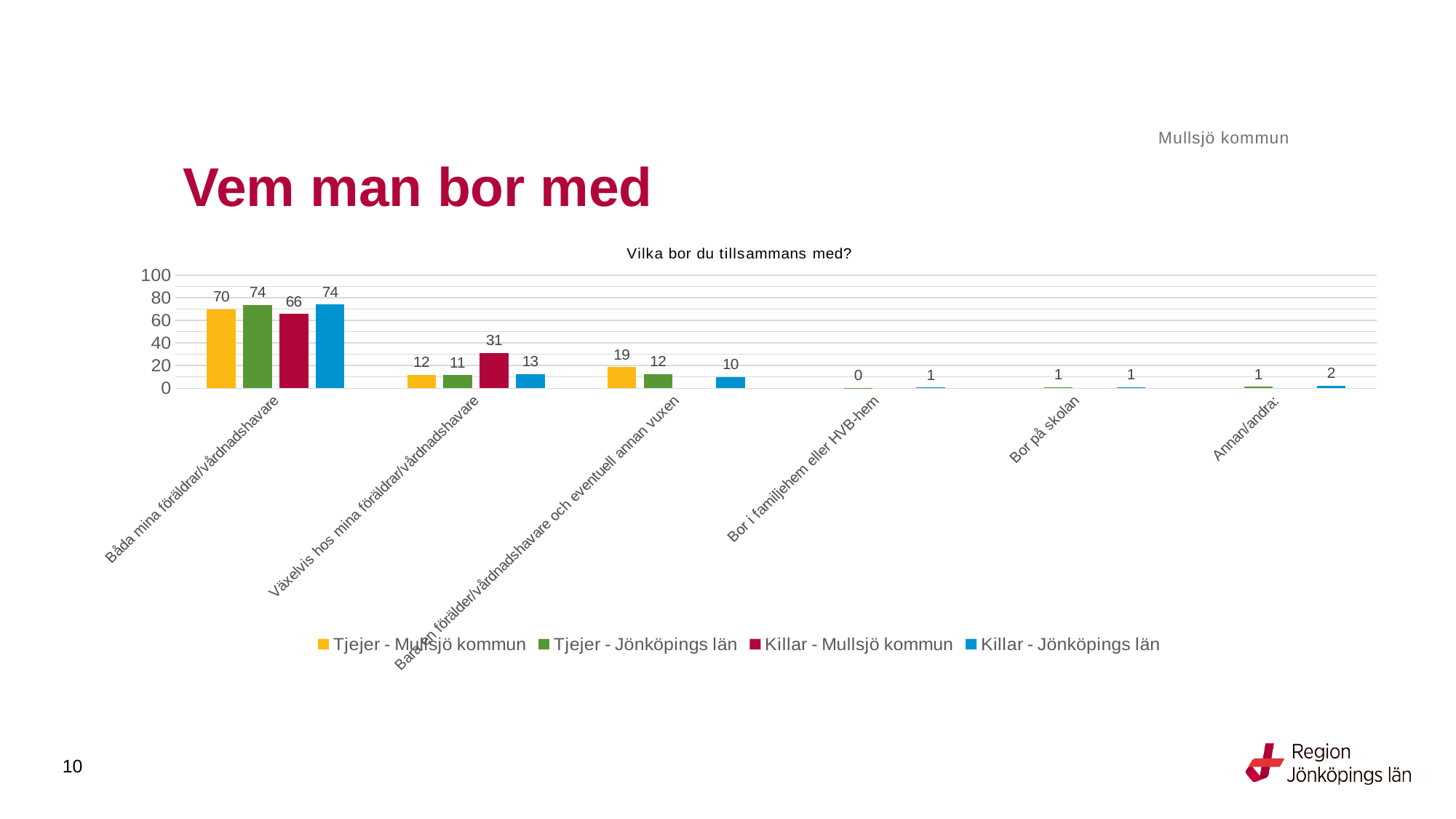
What is the value for Killar - Mullsjö kommun in the category 'Båda mina föräldrar/vårdnadshavare'? 66 What is the title of the chart? Vilka bor du tillsammans med? What is the value for Tjejer - Mullsjö kommun in the category 'Båda mina föräldrar/vårdnadshavare'? 70 What is the value for Tjejer - Jönköpings län in the category 'Växelvis hos mina föräldrar/vårdnadshavare'? 11 Which is larger in the category 'Växelvis hos mina föräldrar/vårdnadshavare': Tjejer - Mullsjö kommun or Killar - Jönköpings län? Killar - Jönköpings län Which category has the lowest values overall across the series? Bor i familjehem eller HVB-hem How many series does the legend list? 4 What is the value for Killar - Mullsjö kommun in the category 'Växelvis hos mina föräldrar/vårdnadshavare'? 31 Which series has the highest value in the category 'Växelvis hos mina föräldrar/vårdnadshavare'? Killar - Mullsjö kommun What is the difference between Tjejer - Jönköpings län and Killar - Mullsjö kommun in the category 'Båda mina föräldrar/vårdnadshavare'? 8 How many categories are shown on the x axis? 6 What type of chart is shown on the slide? bar chart